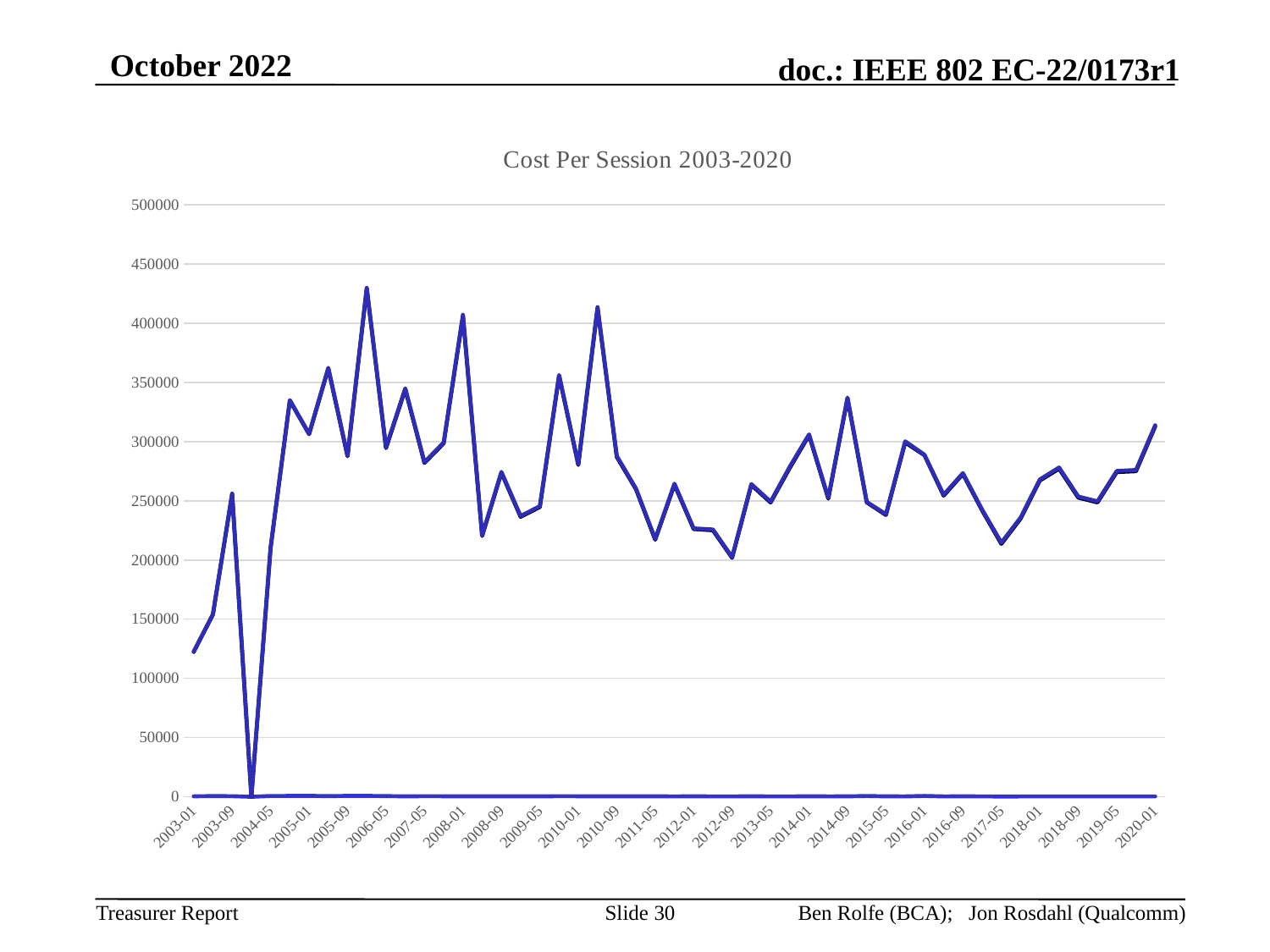
Is the value for 2003-01 greater or less than 150000? less What is the lowest value the line drops to on the chart? 0 Is the value for 2020-01 greater or less than 300000? greater How many date labels are shown along the x axis of the chart? 26 Is the highest value reached by the line greater or less than 400000? greater What is the highest value shown on the vertical axis of the chart? 500000 Which is larger, the value for 2003-01 or the value for 2020-01? 2020-01 Comparing the first point (2003-01) with the last point (2020-01), does the cost per session rise or fall overall? rise What is the title of the chart? Cost Per Session 2003-2020 What kind of chart is shown on the slide? line chart